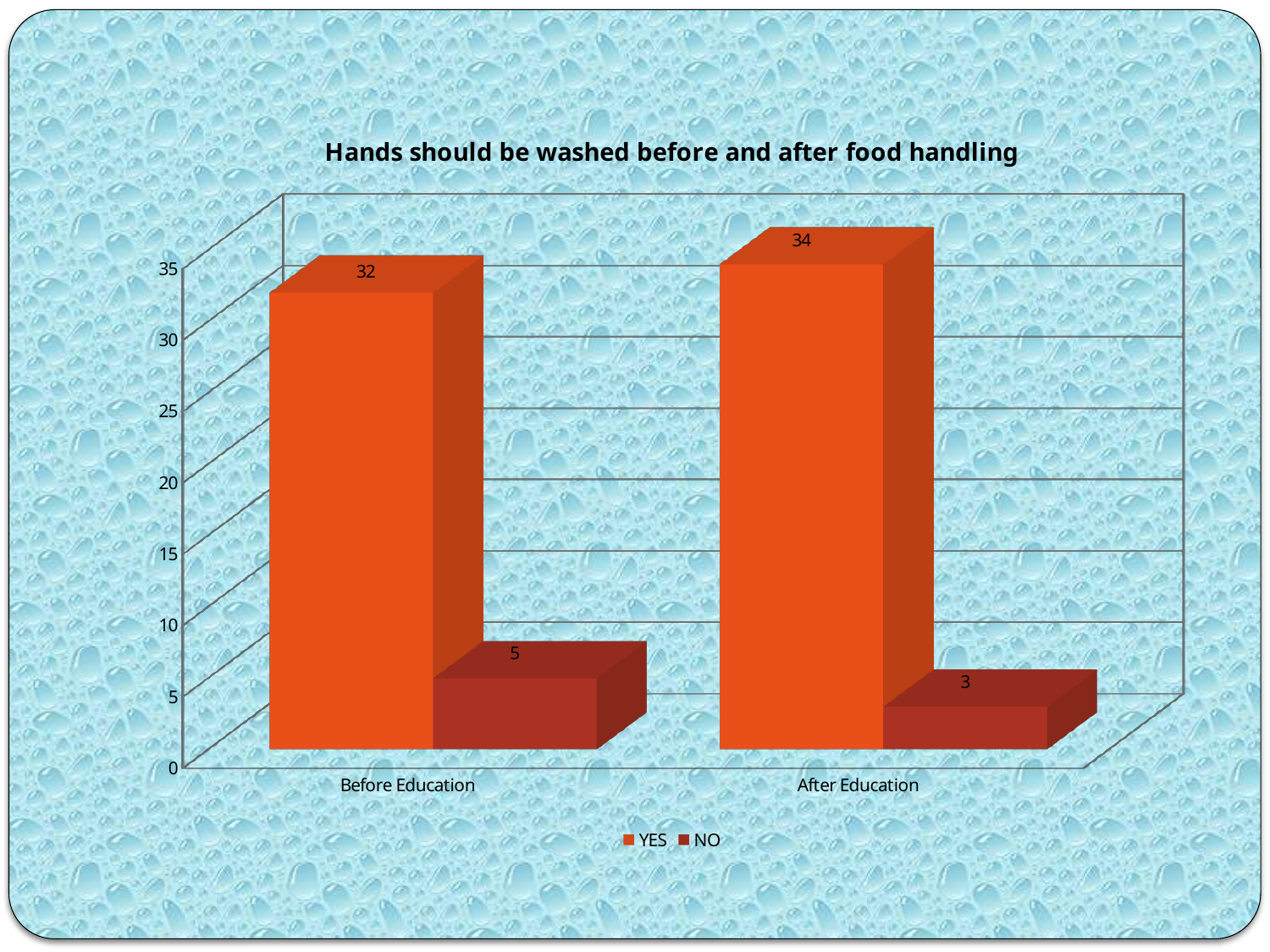
What is the YES value for After Education? 34 What is the difference between the YES values for After Education and Before Education? 2 Is the NO value for Before Education larger or smaller than the NO value for After Education? larger What is the NO value for After Education? 3 Which category has the lower NO value? After Education What is the YES value for Before Education? 32 How many categories are shown on the x axis? 2 Which category has the higher YES value? After Education What is the difference between the YES and NO values for Before Education? 27 How many series does the legend list? 2 What is the NO value for Before Education? 5 What is the title of the chart? Hands should be washed before and after food handling